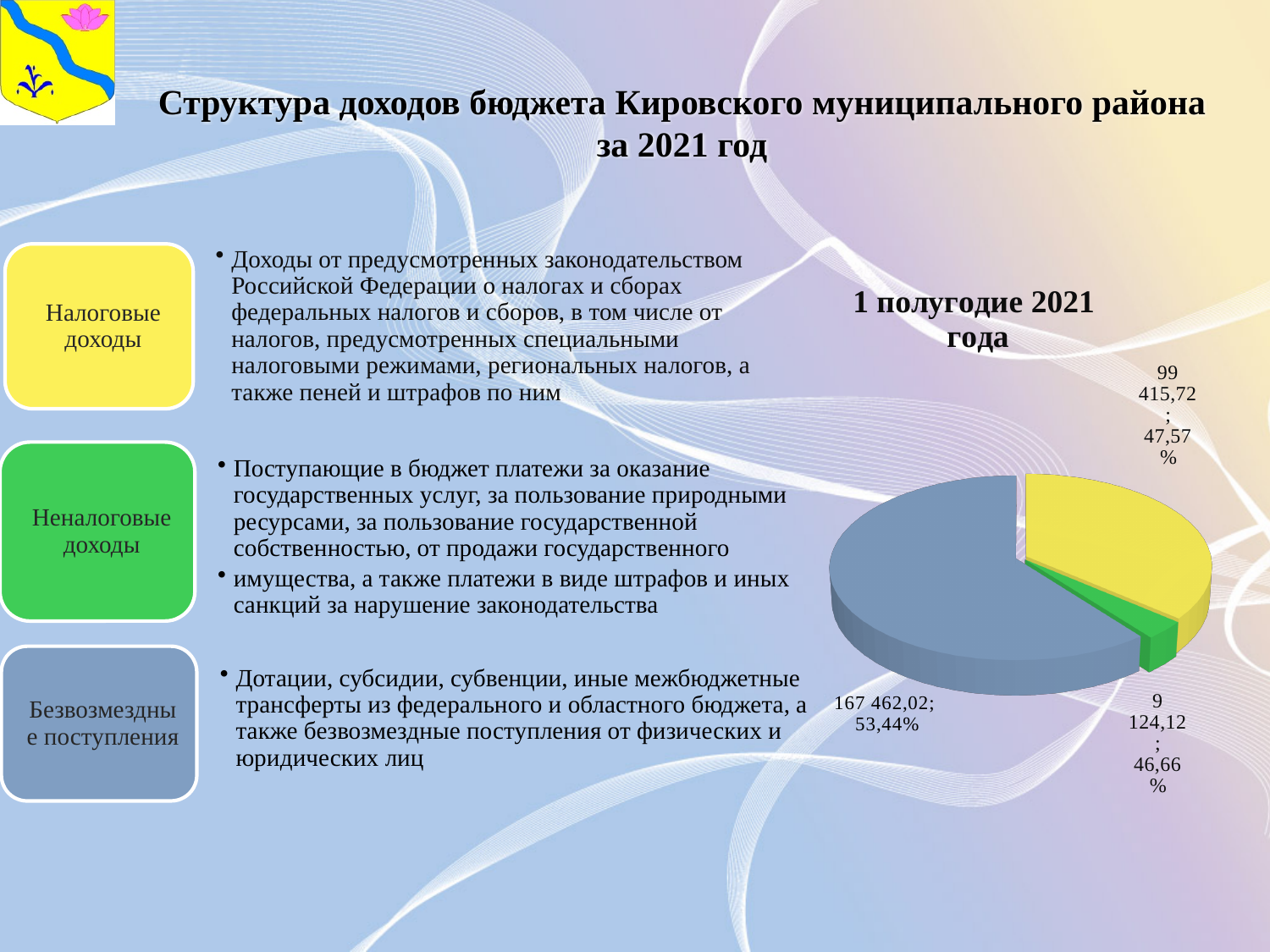
What value is labelled on the green slice of the pie chart? 9 124,12 What percentage share is labelled on the yellow slice of the pie chart? 47,57% What is the title of the pie chart? 1 полугодие 2021 года What value is labelled on the yellow slice of the pie chart? 99 415,72 What is the difference between the value of the blue-grey slice (167 462,02) and the yellow slice (99 415,72)? 68 046,30 How many slices does the pie chart have? 3 What value is labelled on the largest (blue-grey) slice of the pie chart? 167 462,02 Which slice of the pie chart is the largest? the blue-grey slice (167 462,02) Which is larger in the pie chart: the blue-grey slice or the yellow slice? the blue-grey slice What kind of chart is shown on the slide? pie chart Which slice of the pie chart is the smallest? the green slice (9 124,12) What percentage share is labelled on the blue-grey slice of the pie chart? 53,44%